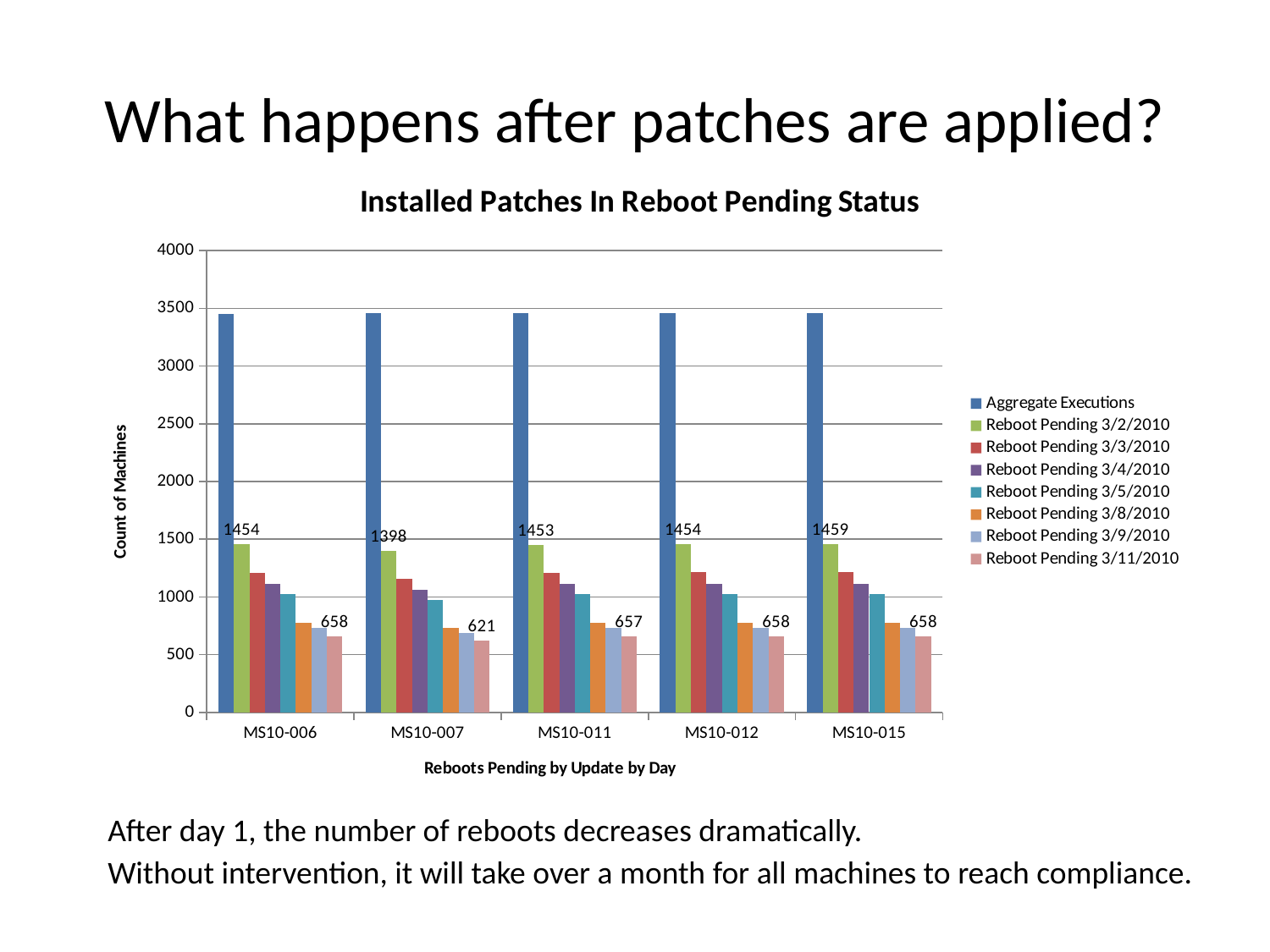
What is the Reboot Pending 3/11/2010 value for MS10-007? 621 Is the Reboot Pending 3/3/2010 value for MS10-006 greater or less than 1000? greater How many updates are shown on the x axis? 5 Which has the larger Reboot Pending 3/2/2010 value, MS10-006 or MS10-007? MS10-006 Which update has the lowest Reboot Pending 3/11/2010 value? MS10-007 For MS10-006, what is the difference between the Reboot Pending 3/2/2010 value and the Reboot Pending 3/11/2010 value? 796 Which update has the lowest Reboot Pending 3/2/2010 value? MS10-007 For MS10-007, what is the difference between the Reboot Pending 3/2/2010 value and the Reboot Pending 3/11/2010 value? 777 What is the Reboot Pending 3/2/2010 value for MS10-007? 1398 How many series does the legend list? 8 Is the Aggregate Executions value for MS10-006 greater or less than 3000? greater What is the Reboot Pending 3/2/2010 value for MS10-015? 1459